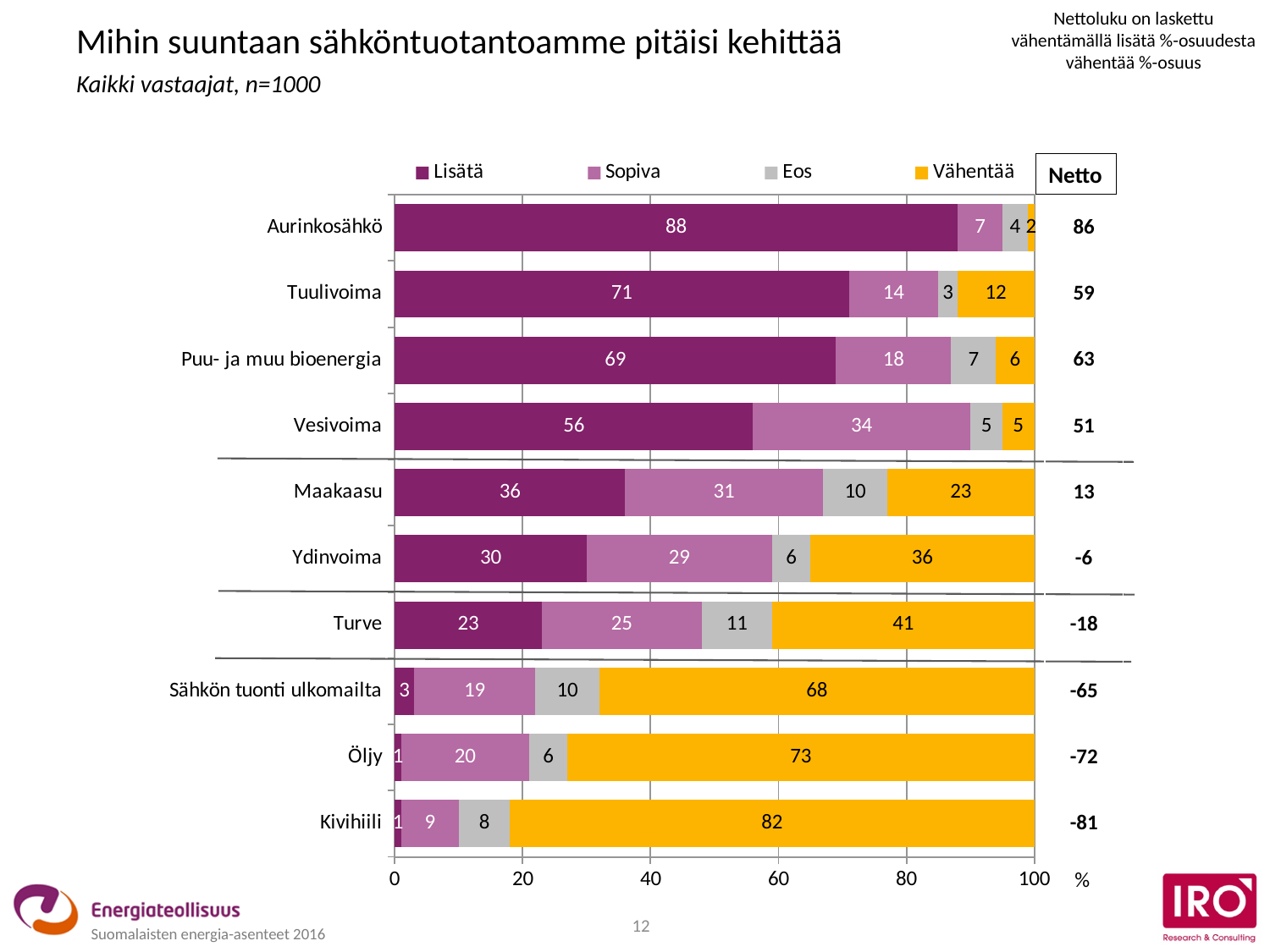
What is the Netto value shown for Ydinvoima? -6 What is the total of the stacked bar for Turve? 100 Which category has the lowest Vähentää value? Aurinkosähkö How many categories are shown on the chart? 10 Which is larger, the Lisätä value for Maakaasu or the Lisätä value for Ydinvoima? Maakaasu What kind of chart is shown on the slide? Stacked bar chart What is the Lisätä value for Tuulivoima? 71 What is the difference between the Vähentää values for Öljy and Sähkön tuonti ulkomailta? 5 What is the Sopiva value for Vesivoima? 34 How many series does the legend list? 4 Which category has the highest Lisätä value? Aurinkosähkö What is the Vähentää value for Kivihiili? 82